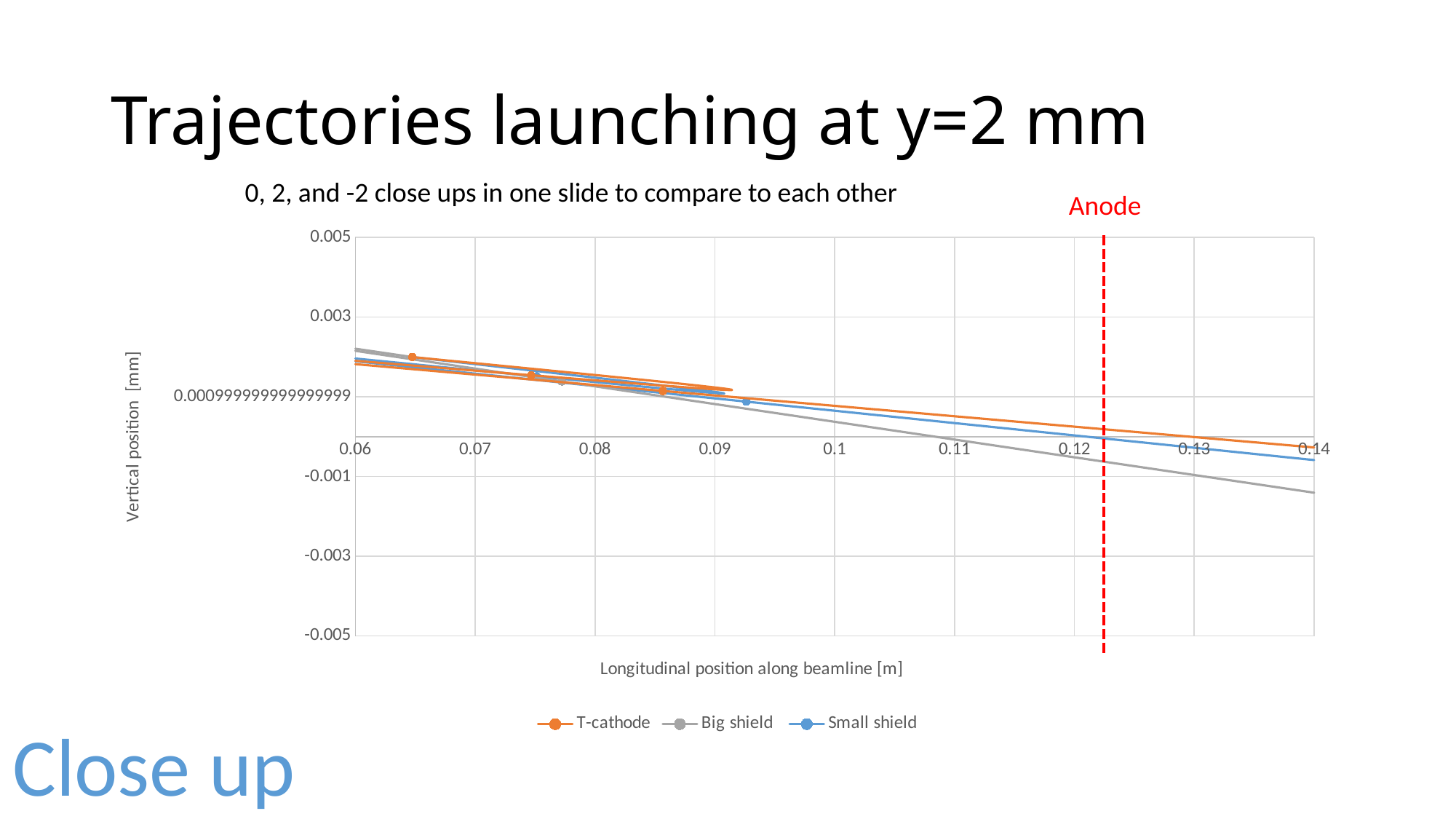
How many series does the legend list? 3 Is the value for Big shield at x = 0.14 greater or less than -0.001? less Do the trajectory values rise or fall as the longitudinal position increases along the x axis? fall What are the three series named in the legend? T-cathode, Big shield, Small shield Which series has the highest vertical position at x = 0.14? T-cathode What is the title of the x axis? Longitudinal position along beamline [m] Is the value for T-cathode at x = 0.14 greater or less than -0.001? greater What kind of chart is shown on the slide? line chart Which series has the lowest vertical position at the right end of the chart (x = 0.14)? Big shield At x = 0.14, is the Small shield value larger or smaller than the Big shield value? larger Is the value for Small shield at x = 0.06 greater or less than 0.003? less What does the red dashed vertical line on the chart mark? Anode